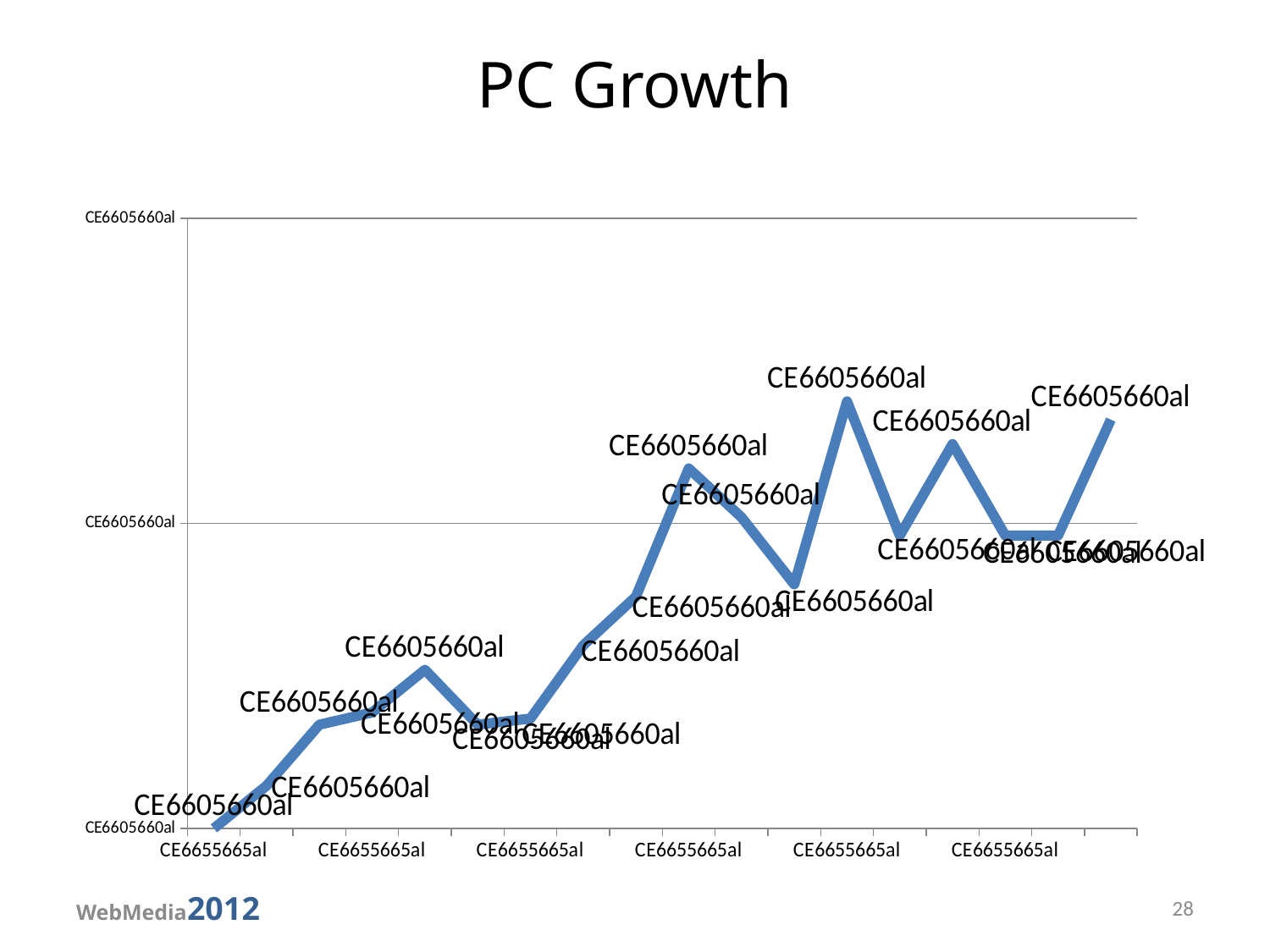
Which is higher, the first point or the last point of the line? the last point Is the lowest point of the line at the left end or the right end of the chart? the left end Overall, do the values rise or fall from left to right along the x axis? rise How many data points are plotted on the line? 18 Is the highest point of the line in the left half or the right half of the chart? the right half What kind of chart is shown on the slide? line chart How many lines are plotted on the chart? 1 What is the title of the chart? PC Growth